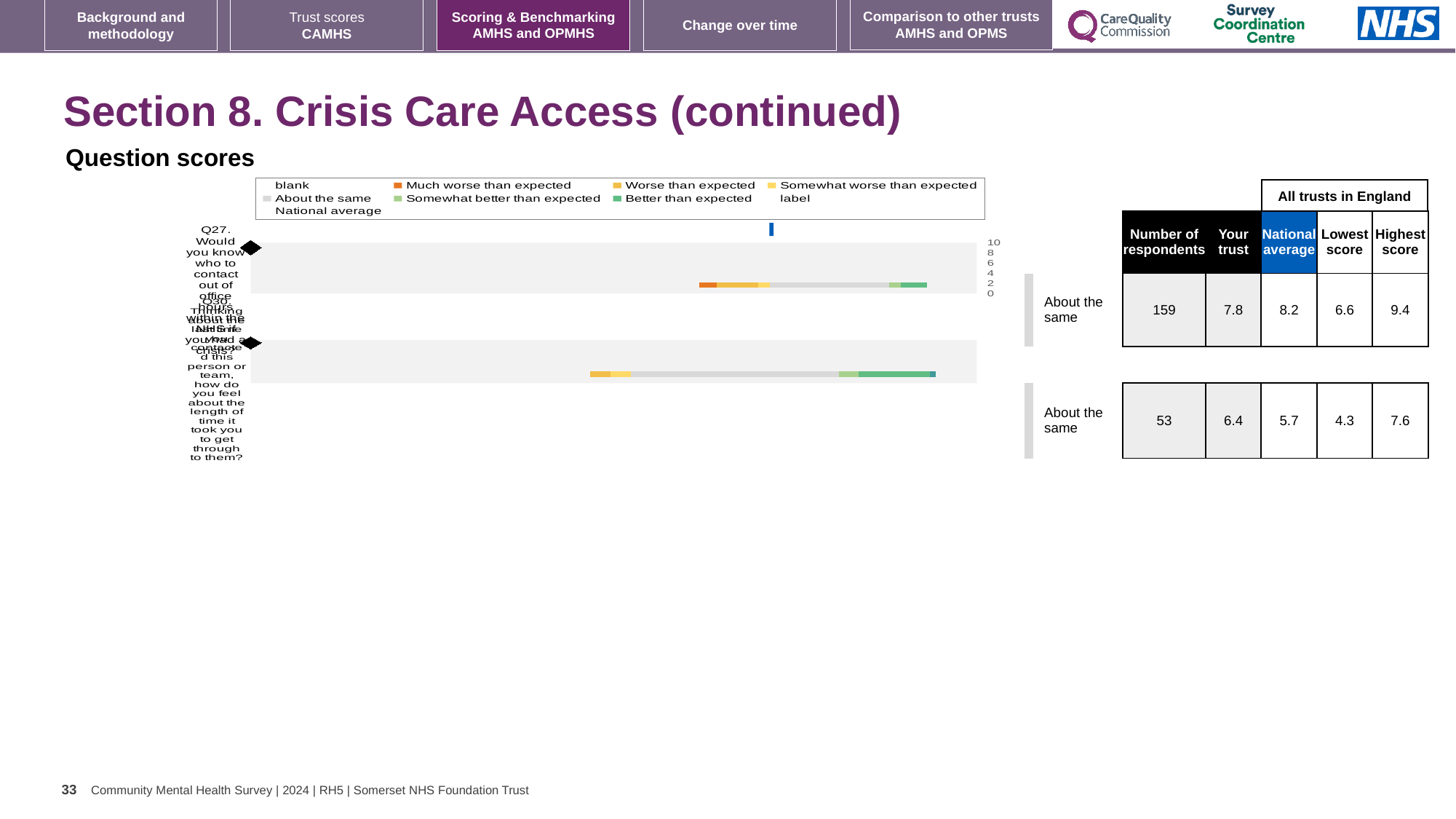
What benchmark category is shown for Q30 next to the chart? About the same What is the national average score for Q27? 8.2 What is the difference between the highest score and the lowest score for Q27? 2.8 What is the 'Your trust' score for Q27? 7.8 For Q30, which is larger: the 'Your trust' score or the national average? Your trust What is the number of respondents for Q30? 53 What is the highest score among all trusts in England for Q27? 9.4 What is the number of respondents for Q27 in the table next to the chart? 159 For Q27, which is larger: the 'Your trust' score or the national average? National average How many questions are plotted in the chart? 2 What is the lowest score among all trusts in England for Q30? 4.3 What kind of chart is shown under 'Question scores'? bar chart